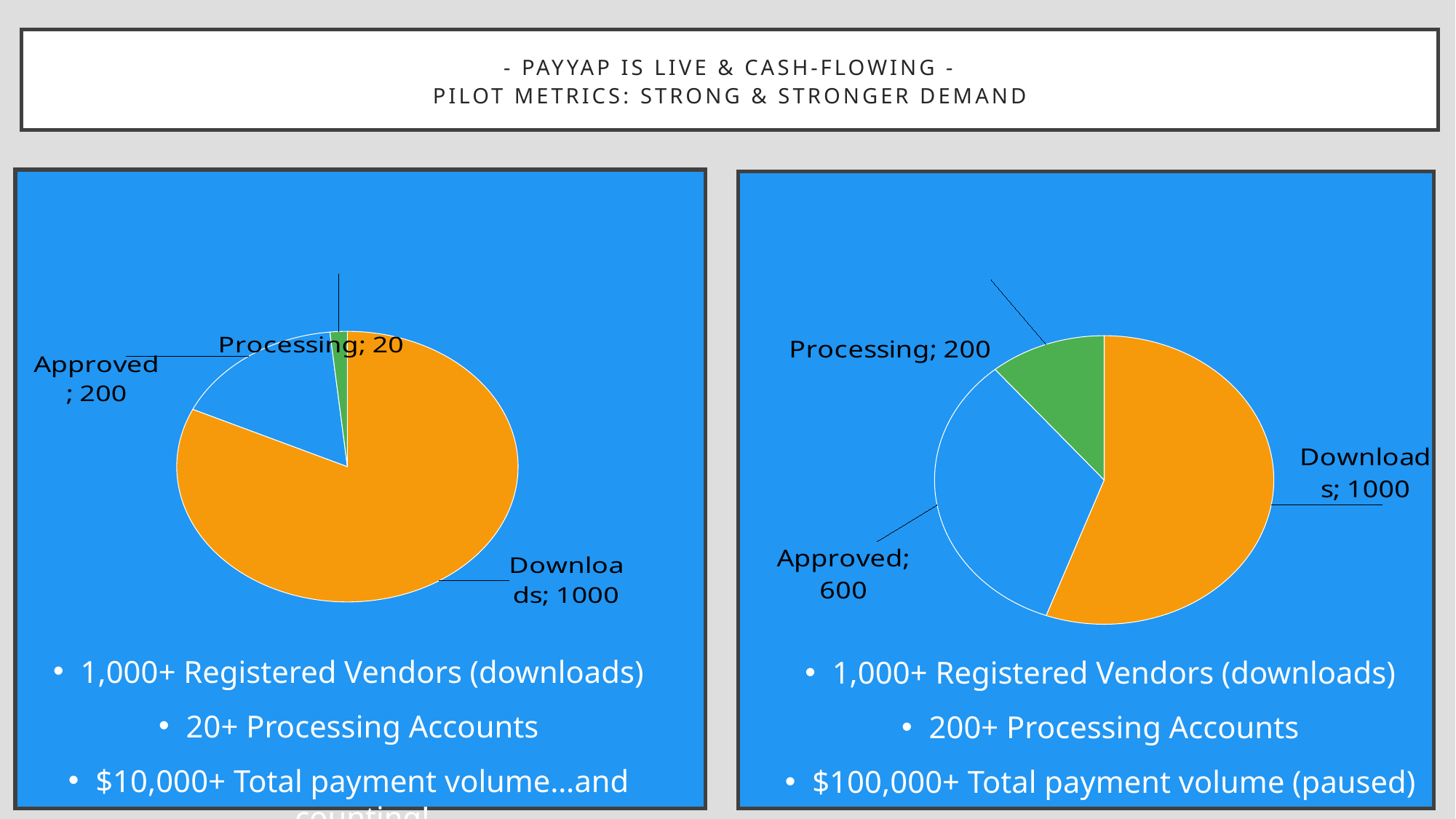
In the left pie chart, what is the value for Downloads? 1000 In the right pie chart, what colour is the Processing slice? Green In the right pie chart, which is larger, Approved or Processing? Approved In the right pie chart, what is the value for Processing? 200 In the right pie chart, which category has the smallest slice? Processing In the left pie chart, which category has the largest slice? Downloads In the right pie chart, what is the difference between the Approved and Processing values? 400 How many categories does the left pie chart show? 3 In the left pie chart, what is the difference between the Downloads and Approved values? 800 In the right pie chart, what is the value for Approved? 600 What type of chart is shown on the right side of the slide? Pie chart In the left pie chart, what is the value for Processing? 20